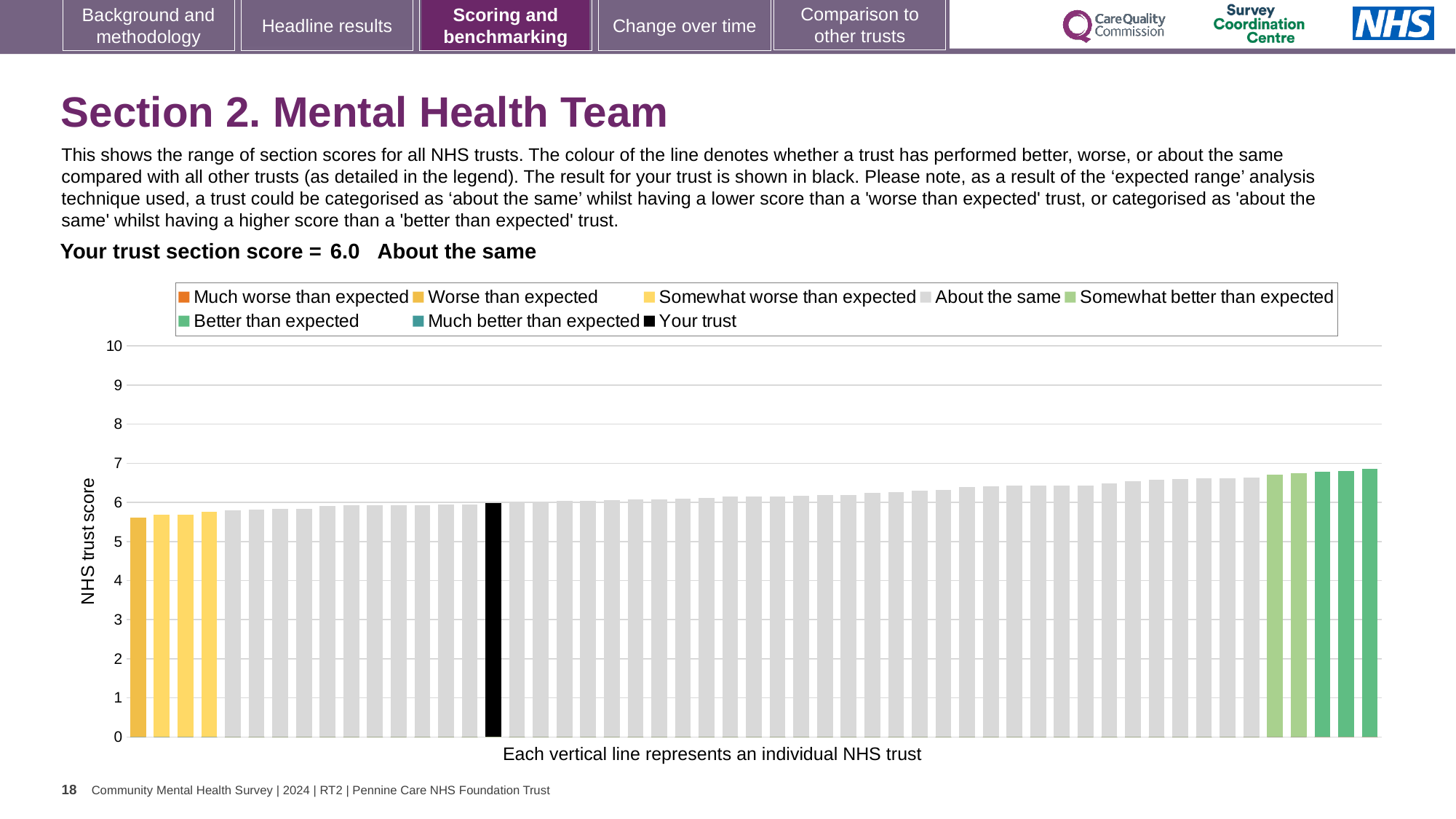
How many entries does the chart legend list? 8 Which performance category is your trust placed in for this section? About the same Is the value of the highest bar in the chart greater or less than 7? less Is the value of the lowest bar in the chart greater or less than 5? greater What colour is the bar representing your trust? black How many bars are coloured as 'Better than expected' (dark green)? 3 Is the value for your trust (the black bar) greater or less than 5? greater Do the bar values rise or fall from left to right across the chart? rise What is the section score for your trust shown on the slide? 6.0 What is the label on the vertical axis of the chart? NHS trust score What type of chart is used to show the NHS trust section scores? bar chart Which legend category do the tallest bars on the right of the chart belong to? Better than expected